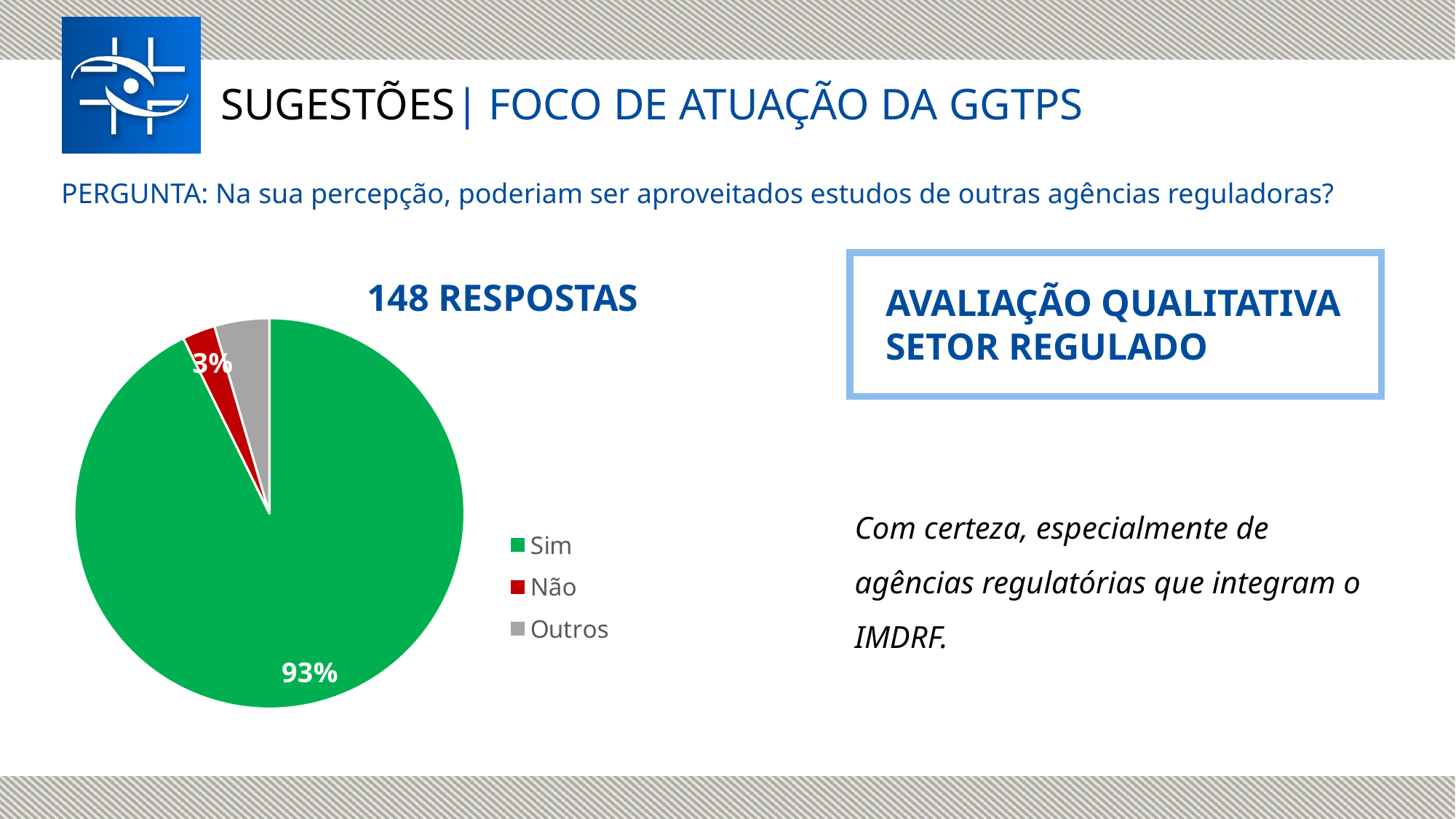
What kind of chart is shown on the slide? Pie chart What is the difference in percentage points between the "Sim" slice and the "Não" slice? 90 percentage points Which category has the largest slice of the pie? Sim What percentage is shown for the "Não" slice? 3% How many categories does the pie chart show? 3 How many entries does the chart legend list? 3 What colour is used for the "Sim" slice? Green What share of the pie does the "Sim" slice represent? 93% What is the title of the chart? 148 RESPOSTAS Which is larger, the "Sim" slice or the "Não" slice? Sim